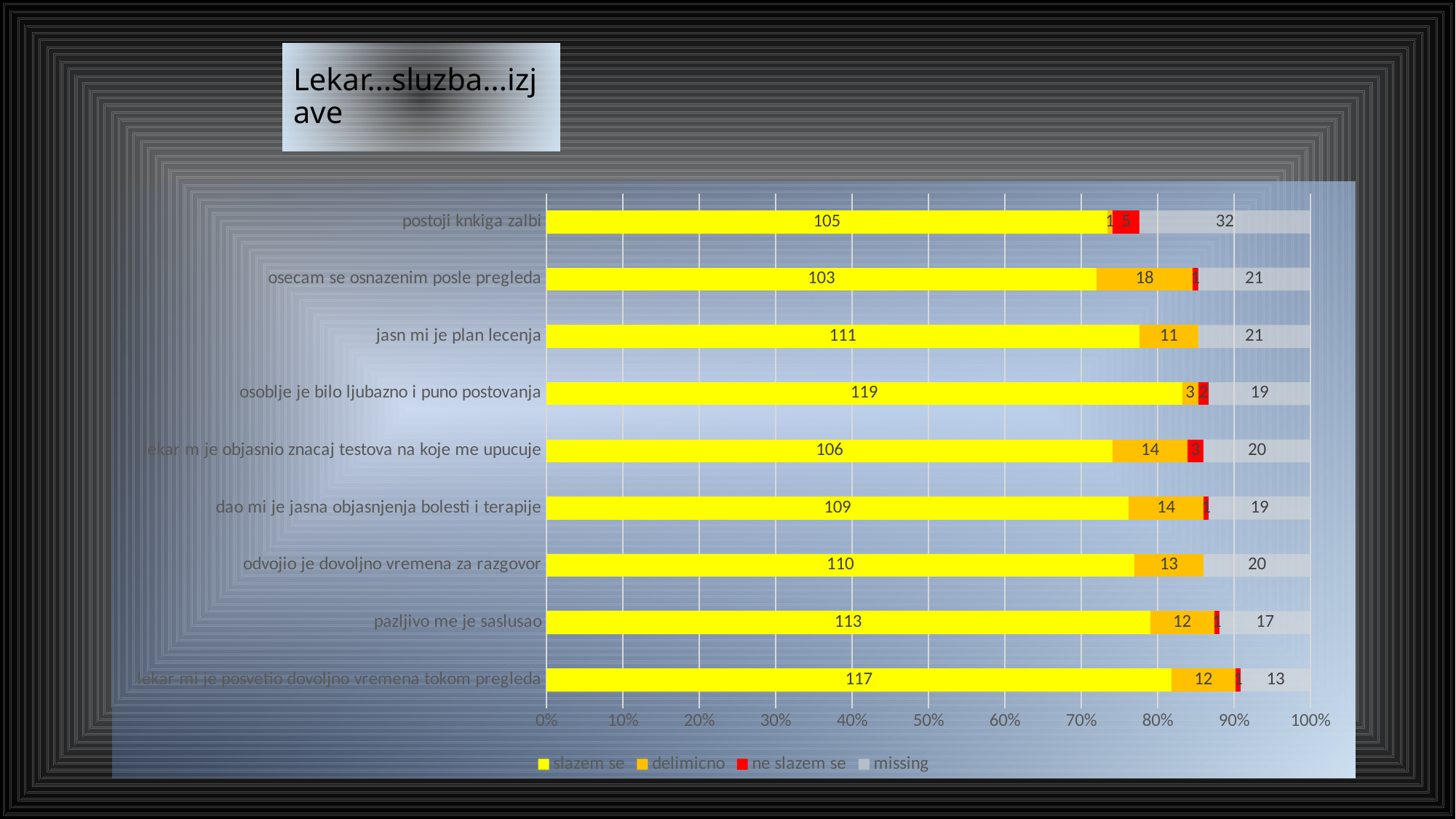
What is the 'missing' value for 'postoji knkiga zalbi'? 32 Which category has the highest 'slazem se' value? osoblje je bilo ljubazno i puno postovanja How many categories are shown on the chart? 9 How many series does the legend list? 4 Which is larger: the 'missing' value for 'postoji knkiga zalbi' or for 'lekar mi je posvetio dovoljno vremena tokom pregleda'? postoji knkiga zalbi Which category has the lowest 'slazem se' value? osecam se osnazenim posle pregleda What is the 'slazem se' value for 'jasn mi je plan lecenja'? 111 What is the difference between the 'slazem se' values for 'lekar mi je posvetio dovoljno vremena tokom pregleda' and 'pazljivo me je saslusao'? 4 What is the total of the stacked bar for 'odvojio je dovoljno vremena za razgovor'? 143 Which series is shown in red in the legend? ne slazem se What kind of chart is shown on the slide? stacked bar chart What is the 'delimicno' value for 'osecam se osnazenim posle pregleda'? 18